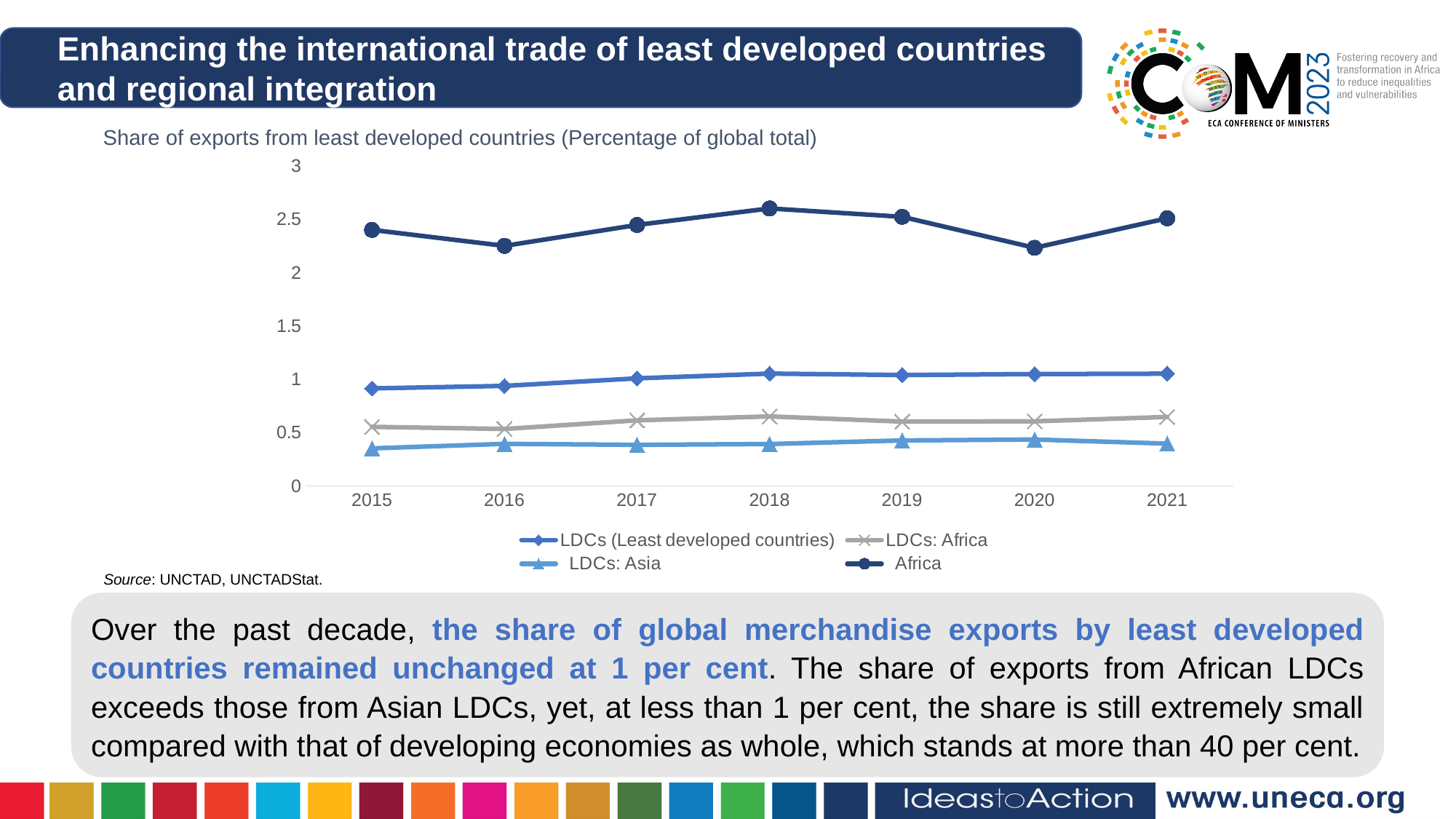
Which series has the highest values across all years? Africa Which is larger in 2019, LDCs: Africa or LDCs: Asia? LDCs: Africa Is the value for Africa in 2016 greater or less than 2.5? less What kind of chart is shown on the slide? line chart What is the title of the chart? Share of exports from least developed countries (Percentage of global total) Is the value for LDCs: Asia in 2015 greater or less than 0.5? less Which series has the lowest values across all years? LDCs: Asia Is the value for LDCs (Least developed countries) in 2015 greater or less than 1? less In which year does the Africa series reach its highest value? 2018 How many years are plotted along the x axis? 7 How many series does the legend list? 4